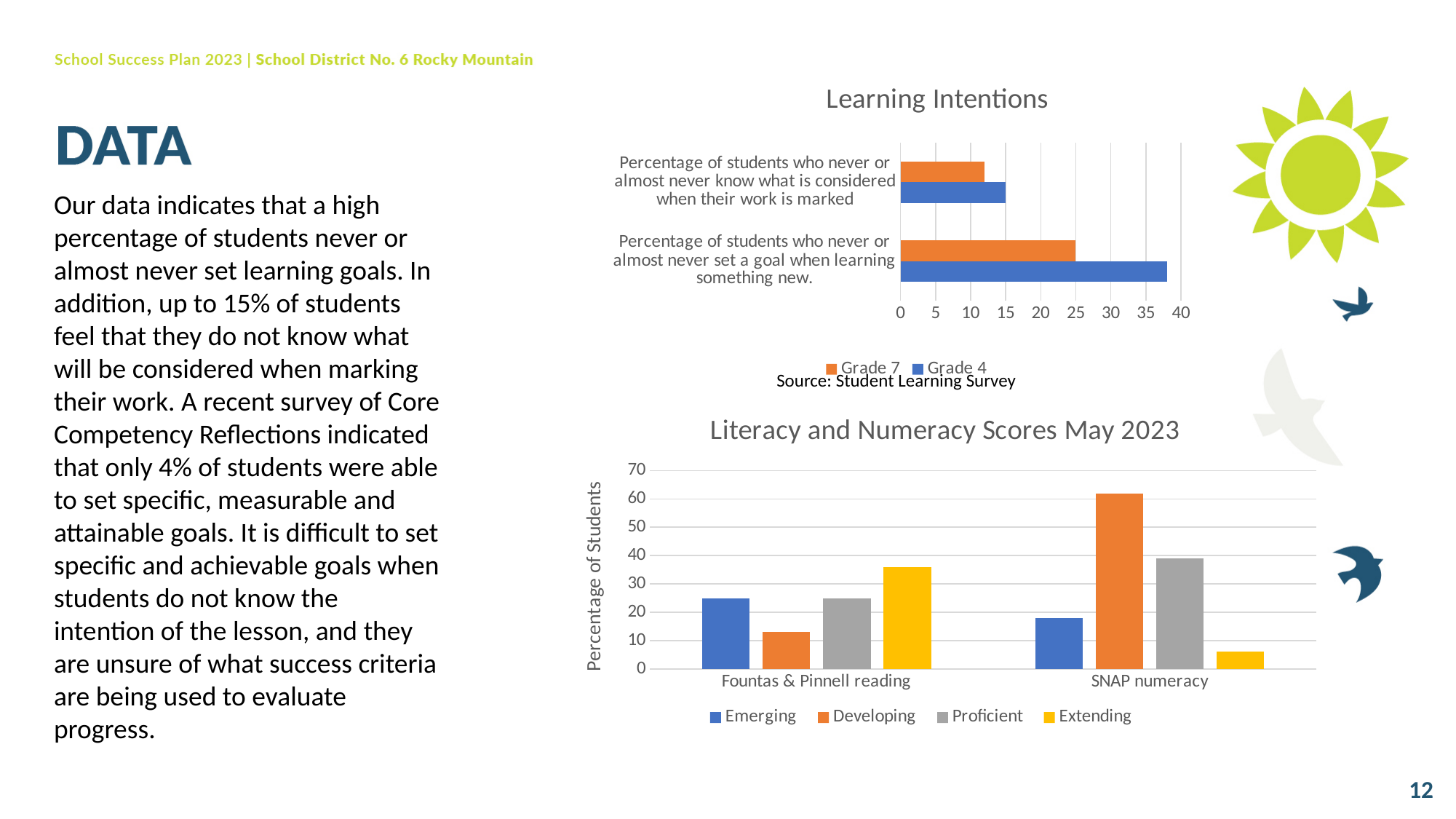
In the 'Literacy and Numeracy Scores May 2023' chart, which series has the highest value for SNAP numeracy? Developing How many series does the legend of the 'Literacy and Numeracy Scores May 2023' chart list? 4 In the 'Learning Intentions' chart, which grade has the larger value for students who never or almost never set a goal when learning something new? Grade 4 In the 'Learning Intentions' chart, is the Grade 7 value for students who never or almost never know what is considered when their work is marked greater or less than 15? less How many categories are shown on the x axis of the 'Literacy and Numeracy Scores May 2023' chart? 2 In the 'Literacy and Numeracy Scores May 2023' chart, which series has the lowest value for SNAP numeracy? Extending What is the source cited below the 'Learning Intentions' chart? Student Learning Survey In the 'Learning Intentions' chart, is the Grade 4 value for students who never or almost never set a goal when learning something new greater or less than 35? greater In the 'Literacy and Numeracy Scores May 2023' chart, which series has the highest value for Fountas & Pinnell reading? Extending What kind of chart is the 'Learning Intentions' chart? bar chart How many series does the legend of the 'Learning Intentions' chart list? 2 In the 'Literacy and Numeracy Scores May 2023' chart, is the Developing value for SNAP numeracy greater or less than 60? greater